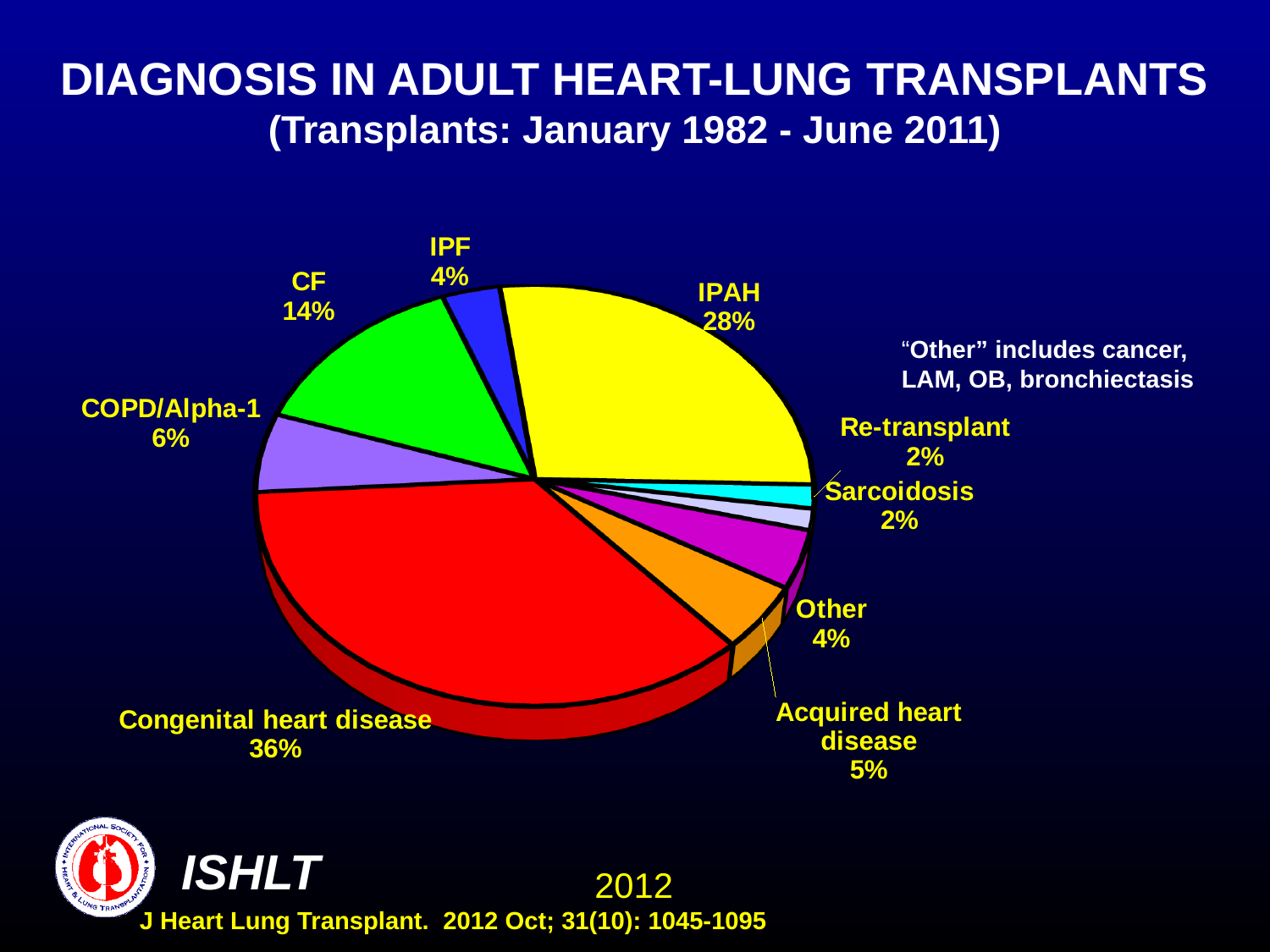
How many diagnosis categories are shown in the pie chart? 9 Which is larger, the share for CF or the share for COPD/Alpha-1? CF According to the note on the slide, what does the "Other" category include? Cancer, LAM, OB, bronchiectasis What is the difference in percentage points between Congenital heart disease and IPAH? 8% Which diagnosis has the largest slice of the pie? Congenital heart disease What share does CF account for? 14% What percentage is shown for COPD/Alpha-1? 6% Which diagnoses share the smallest slice of the pie at 2%? Re-transplant and Sarcoidosis What share is labelled for Acquired heart disease? 5% What share of adult heart-lung transplants is attributed to Congenital heart disease? 36% What percentage of the pie is IPAH? 28% What kind of chart is shown on the slide? Pie chart